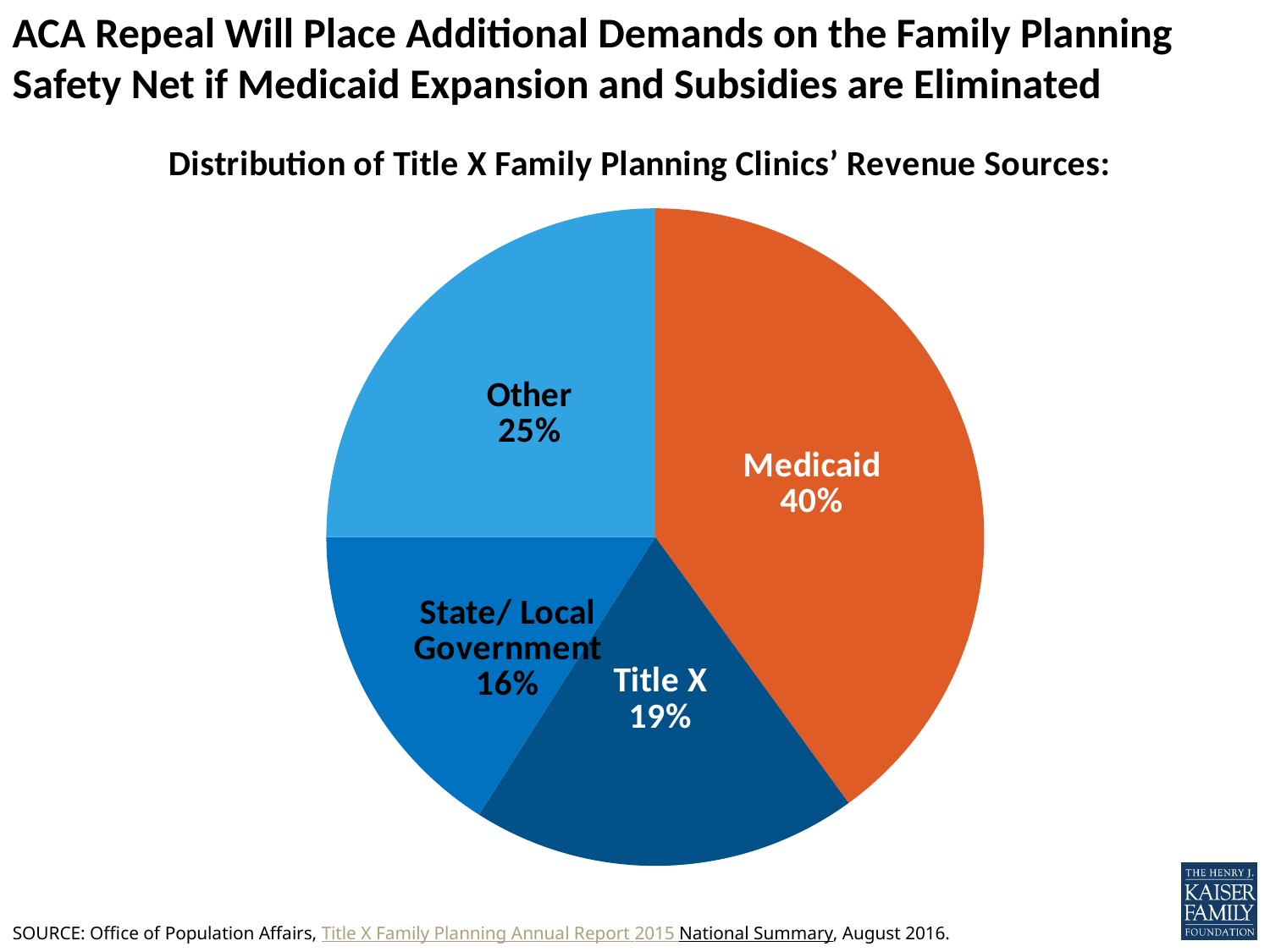
What is the title of the chart? Distribution of Title X Family Planning Clinics' Revenue Sources: What share of Title X family planning clinics' revenue comes from Medicaid? 40% What share of revenue comes from Title X? 19% Which revenue source accounts for the smallest share of the pie? State/ Local Government Which revenue source accounts for the largest share of the pie? Medicaid What share of revenue comes from Other sources? 25% What share of revenue comes from State/ Local Government? 16% How many revenue sources are shown in the pie chart? 4 What is the combined share of Title X and State/ Local Government revenue? 35% Which is larger, the Other share or the Title X share? Other How many percentage points larger is the Medicaid share than the Title X share? 21 What kind of chart is shown on the slide? Pie chart